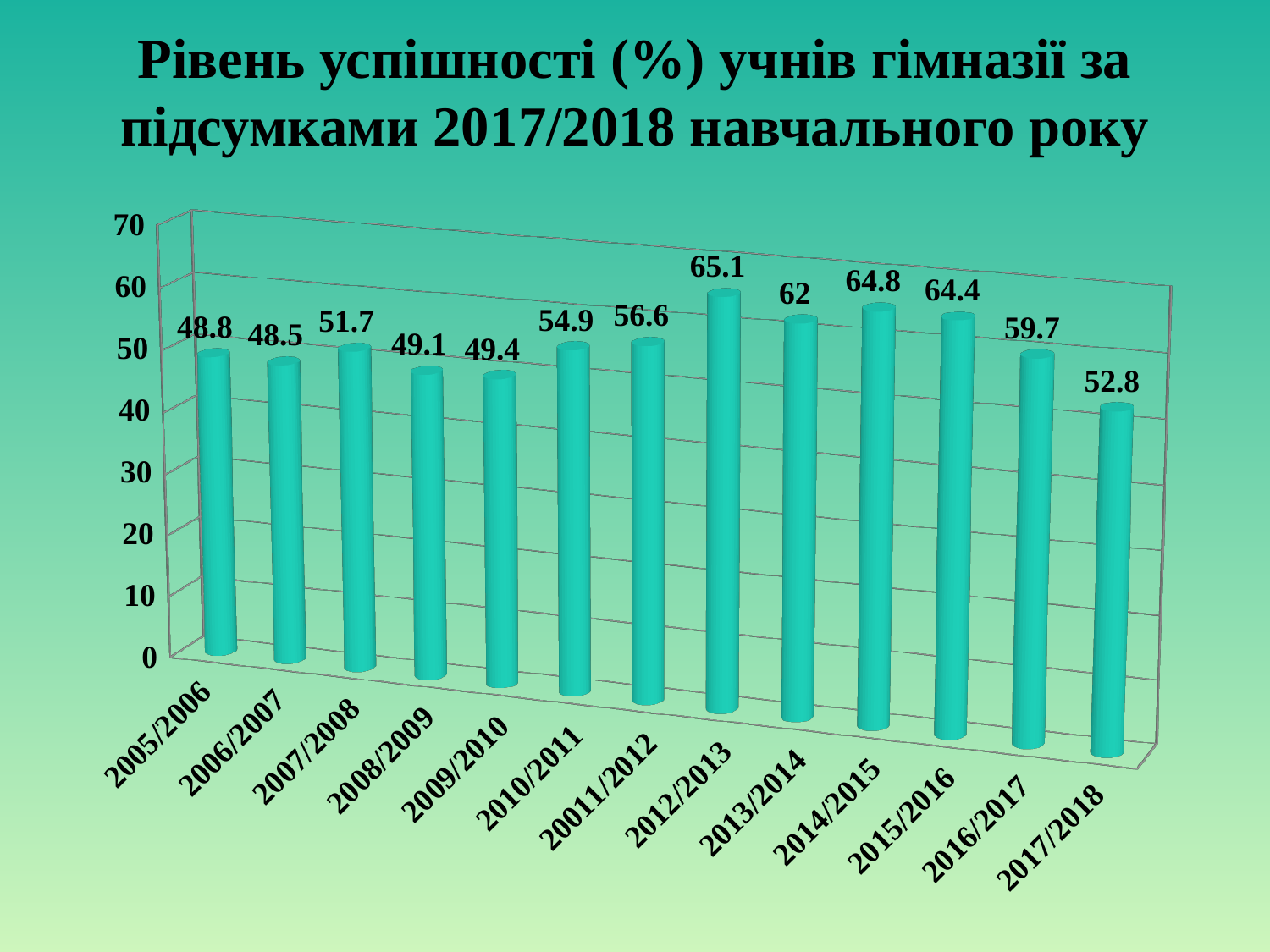
Which is larger, the value for 2014/2015 or the value for 2015/2016? 2014/2015 How many school years are shown on the chart? 13 What kind of chart is shown on the slide? bar chart Do the values rise or fall from 2012/2013 to 2017/2018? fall What is the difference between the values for 2012/2013 and 2017/2018? 12.3 What is the value for 2009/2010? 49.4 What is the value for 2013/2014? 62 Is the value for 2010/2011 greater or less than 50? greater Which school year has the highest value? 2012/2013 Which school year has the lowest value? 2006/2007 What is the value for 2017/2018? 52.8 What is the difference between the values for 2007/2008 and 2008/2009? 2.6